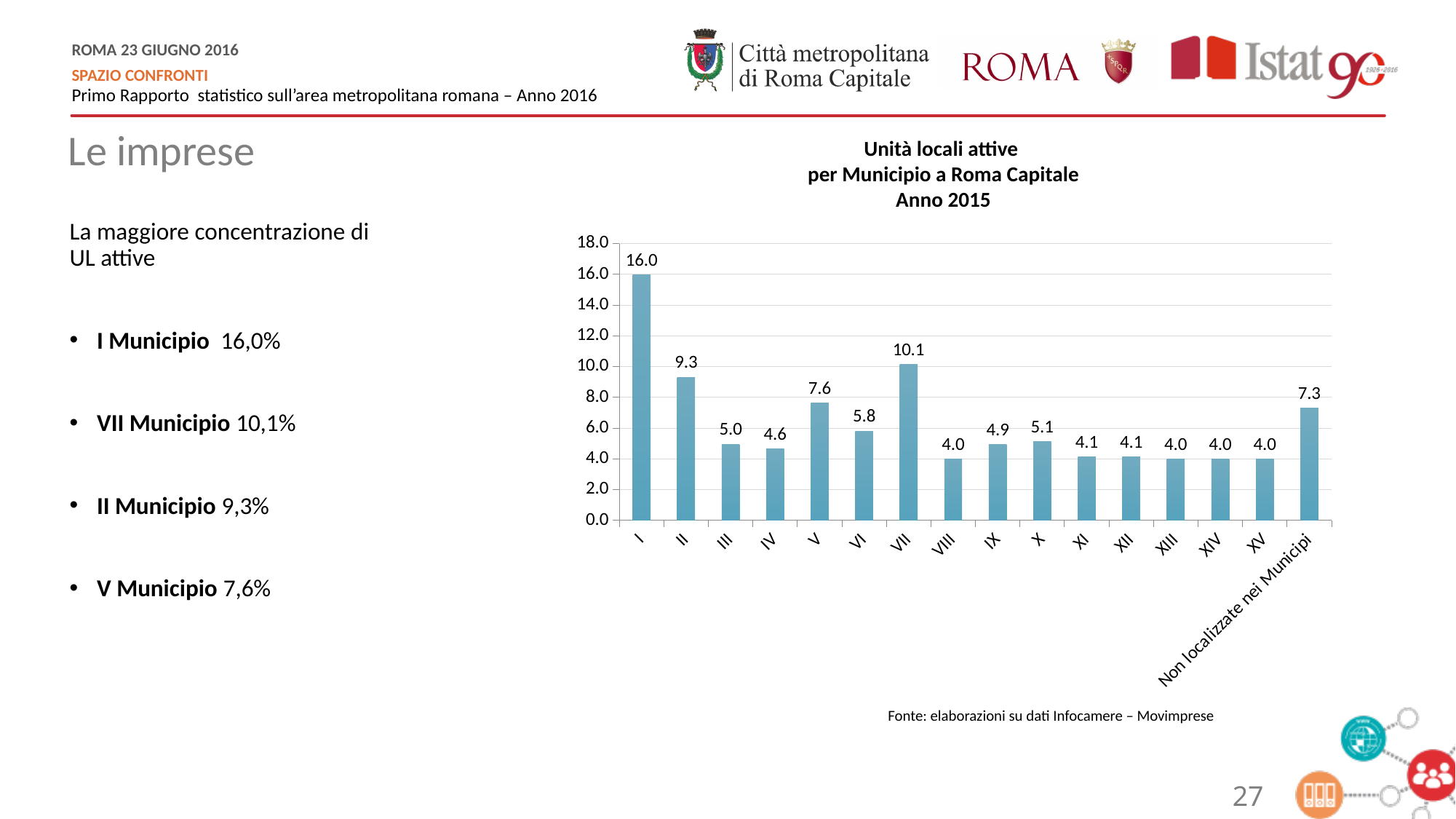
Is the value for Municipio II greater or less than 8.0? greater What is the title of the chart? Unità locali attive per Municipio a Roma Capitale Anno 2015 What is the value for Municipio VII? 10.1 What is the difference between the values for Municipio V and Municipio IV? 3.0 What is the difference between the values for Municipio I and Municipio VII? 5.9 What is the value for 'Non localizzate nei Municipi'? 7.3 Which category has the highest value? I Which has a larger value, Municipio V or Municipio VI? V What is the value for Municipio X? 5.1 How many categories are shown on the x axis? 16 What kind of chart is shown? Bar chart What is the value for Municipio I? 16.0